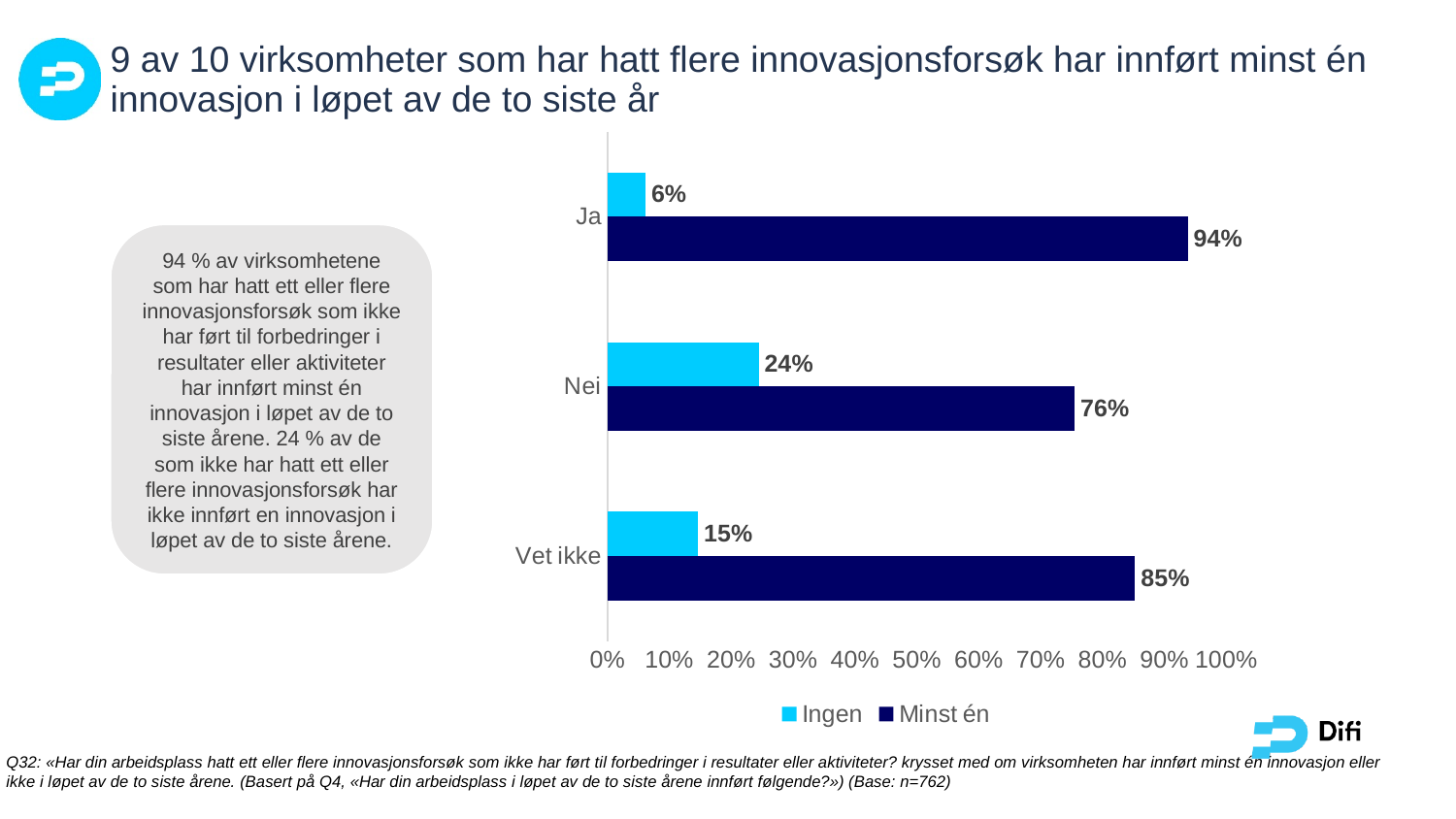
What is the value for "Ingen" in the "Nei" category? 24% What is the value for "Ingen" in the "Vet ikke" category? 15% Is the "Minst én" value for "Nei" greater or less than 70%? greater What kind of chart is shown on the slide? Bar chart Which category has the lowest value for "Ingen"? Ja Which is larger: the "Ingen" value for "Nei" or the "Ingen" value for "Vet ikke"? Nei Which category has the highest value for "Minst én"? Ja How many series does the legend list? 2 What is the difference between the "Minst én" and "Ingen" values in the "Nei" category? 52% How many categories are shown on the chart? 3 What is the value for "Minst én" in the "Vet ikke" category? 85% What is the value for "Minst én" in the "Ja" category? 94%